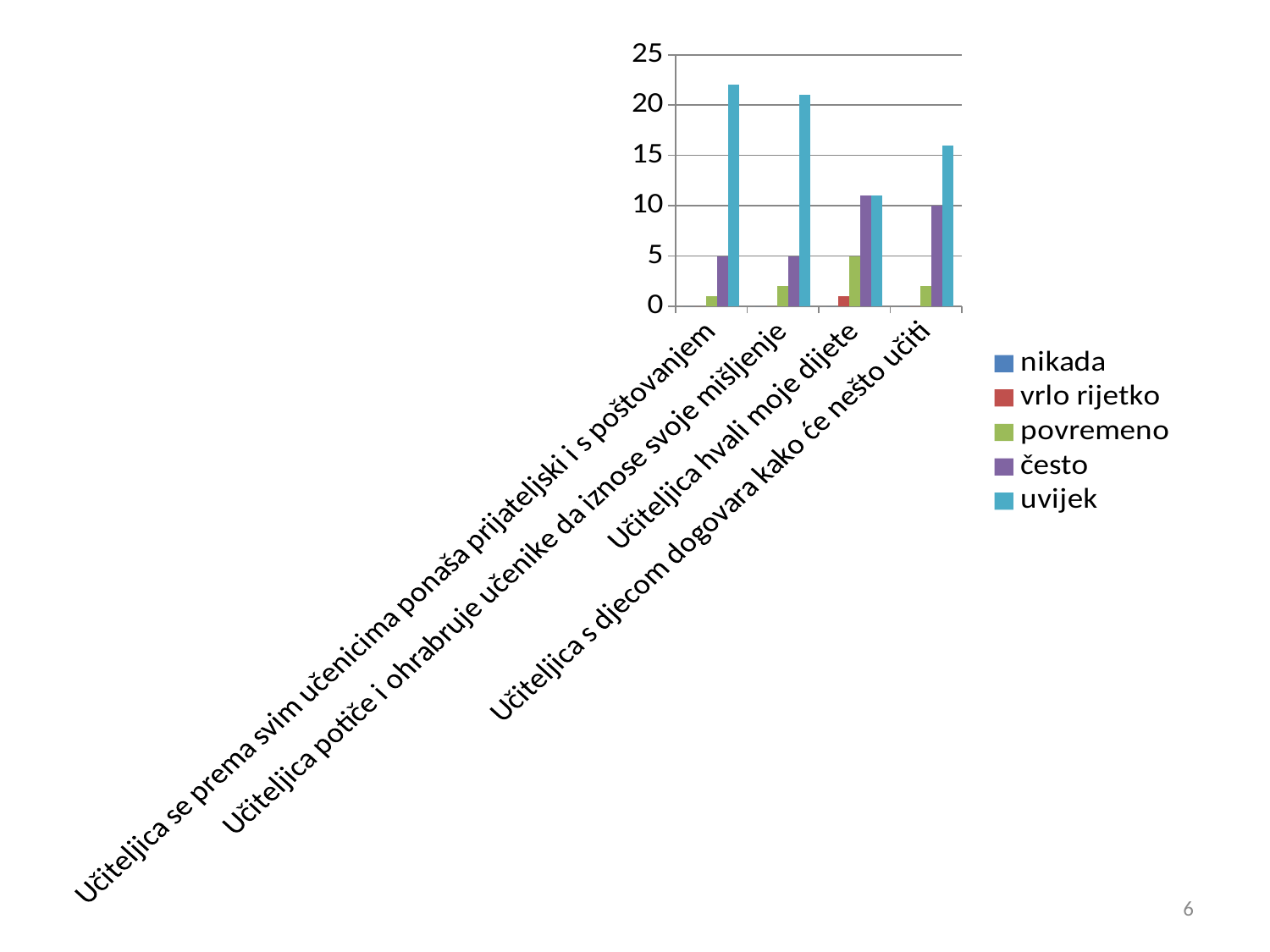
How many categories are shown on the x axis? 4 Which legend entry is shown in light blue? uvijek How many series does the legend list? 5 What kind of chart is shown on the slide? bar chart Which category has the lowest 'uvijek' value? Učiteljica hvali moje dijete Which series has the tallest bar for the category 'Učiteljica se prema svim učenicima ponaša prijateljski i s poštovanjem'? uvijek Is the 'uvijek' value for 'Učiteljica hvali moje dijete' greater or less than 15? less Is the 'uvijek' value for 'Učiteljica se prema svim učenicima ponaša prijateljski i s poštovanjem' greater or less than 20? greater Which category has the highest 'često' value? Učiteljica hvali moje dijete Is the 'često' value for 'Učiteljica hvali moje dijete' greater or less than 10? greater Which is larger: the 'uvijek' value for 'Učiteljica potiče i ohrabruje učenike da iznose svoje mišljenje' or for 'Učiteljica hvali moje dijete'? Učiteljica potiče i ohrabruje učenike da iznose svoje mišljenje